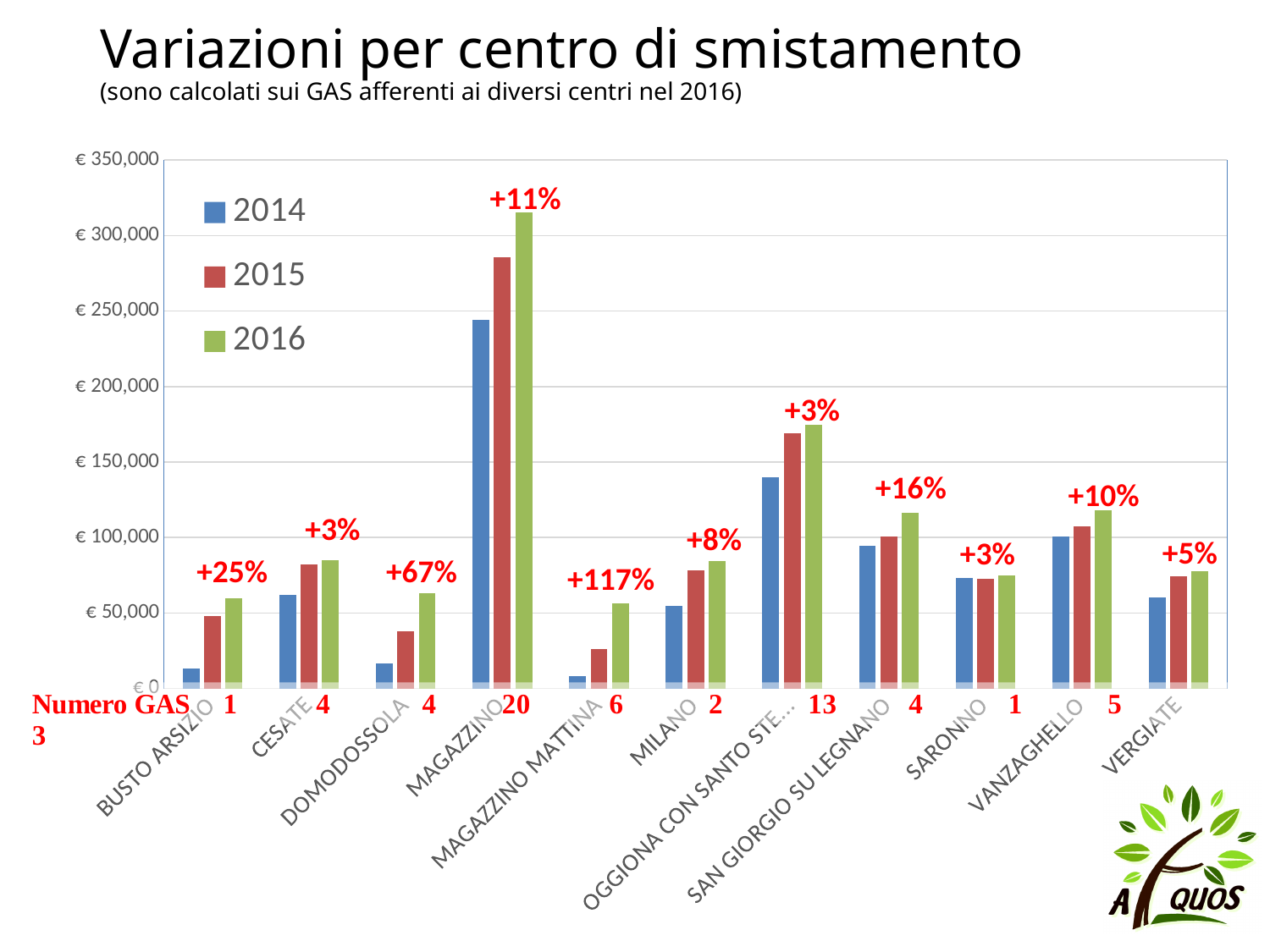
Which has the larger 2016 value, OGGIONA CON SANTO STE... or SAN GIORGIO SU LEGNANO? OGGIONA CON SANTO STE... How many sorting centres (categories) are shown on the x axis? 11 What percentage change is printed above the bars for DOMODOSSOLA? +67% How many series does the legend list? 3 What kind of chart is shown on the slide? bar chart Which centre has the largest printed percentage change? MAGAZZINO MATTINA Is the 2014 value for BUSTO ARSIZIO greater or less than € 50,000? less What percentage change is printed above the bars for MAGAZZINO MATTINA? +117% Which centre has the highest 2016 value? MAGAZZINO What percentage change is printed above the bars for SAN GIORGIO SU LEGNANO? +16% Do the values for MAGAZZINO MATTINA rise or fall from 2014 to 2016? rise Is the 2016 value for MAGAZZINO greater or less than € 300,000? greater